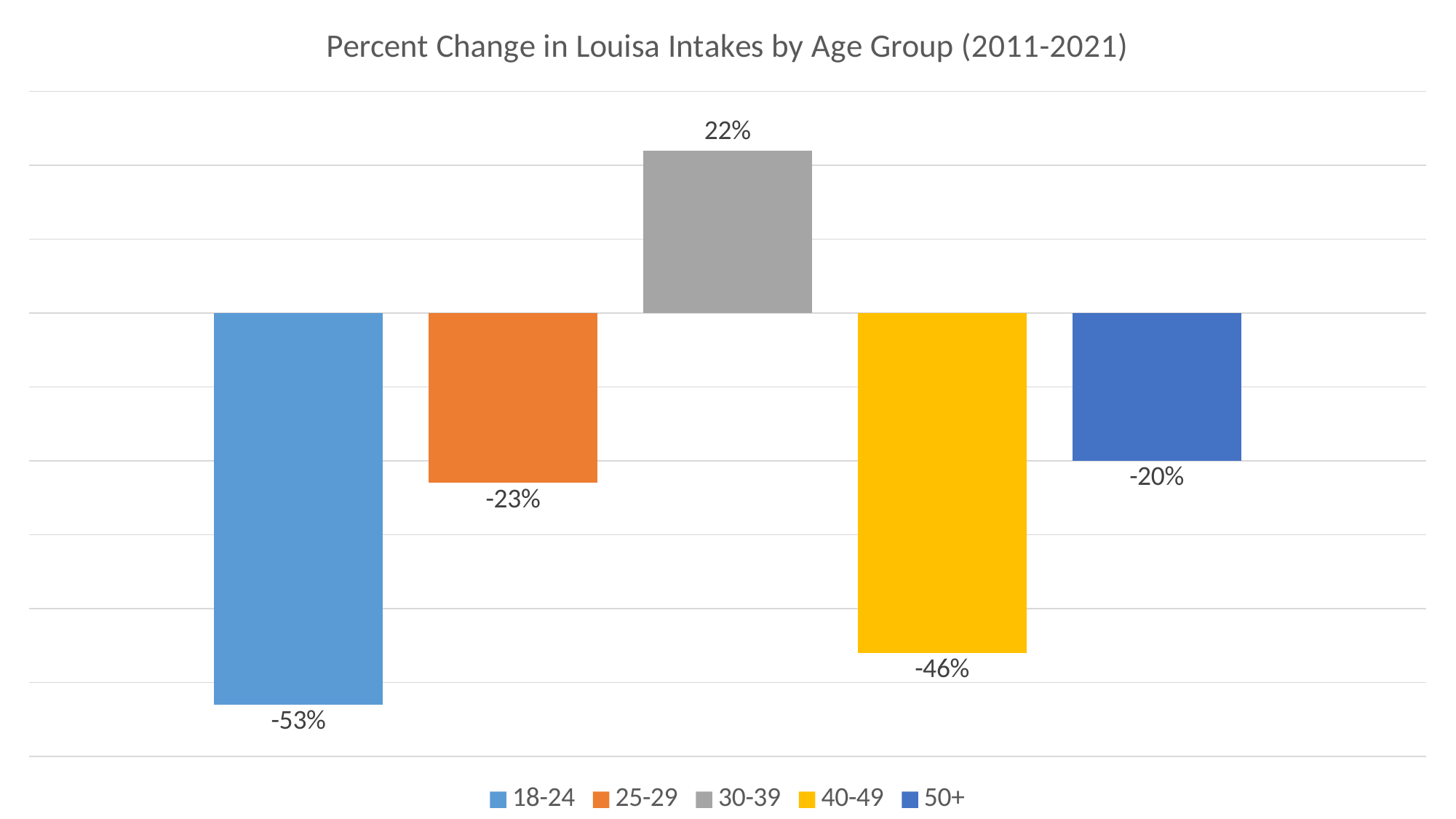
Which age group has the lowest percent change in Louisa intakes? 18-24 How many entries does the legend list? 5 What is the percent change in Louisa intakes for the 30-39 age group? 22% What is the percent change in Louisa intakes for the 18-24 age group? -53% Which age group has a larger percent change, 25-29 or 50+? 50+ What kind of chart is shown on the slide? Bar chart Which age group has the highest percent change in Louisa intakes? 30-39 How many age groups are shown in the chart? 5 What is the difference between the percent change for the 18-24 group and the 40-49 group? 7 percentage points What is the percent change in Louisa intakes for the 50+ age group? -20% What is the percent change in Louisa intakes for the 40-49 age group? -46% What is the title of the chart? Percent Change in Louisa Intakes by Age Group (2011-2021)